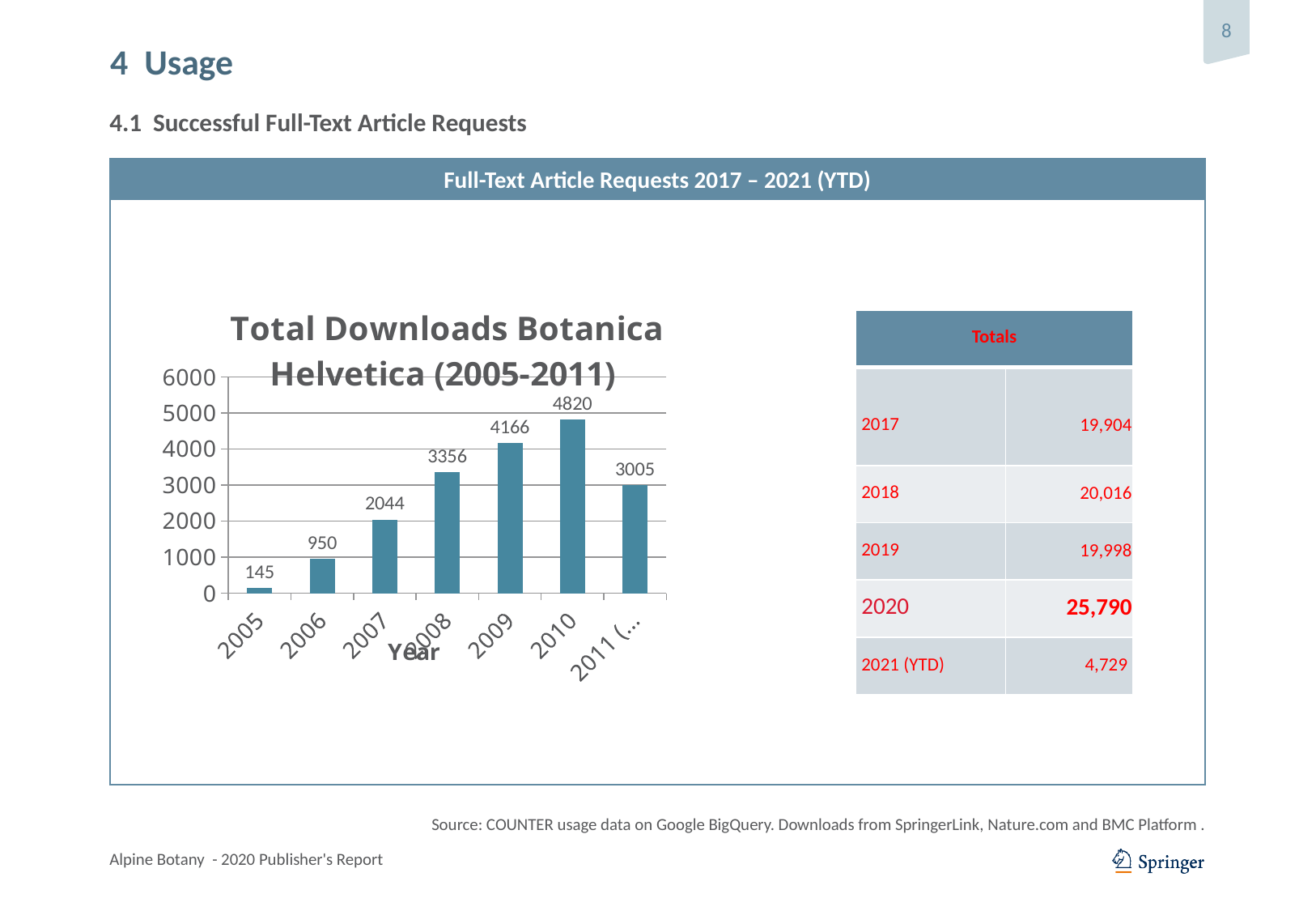
How many bars are plotted in the Total Downloads Botanica Helvetica chart? 7 What is the value for 2009 in the Total Downloads Botanica Helvetica chart? 4166 In the Total Downloads Botanica Helvetica chart, is the value for 2006 greater or less than 1000? less What is the difference between the values for 2010 and 2009 in the Total Downloads Botanica Helvetica chart? 654 What is the difference between the values for 2008 and 2007 in the Total Downloads Botanica Helvetica chart? 1312 In the Total Downloads Botanica Helvetica chart, do the values rise or fall from 2005 to 2010? rise What is the value for 2005 in the Total Downloads Botanica Helvetica chart? 145 What kind of chart is the Total Downloads Botanica Helvetica chart? bar chart Which year has the highest value in the Total Downloads Botanica Helvetica chart? 2010 In the Total Downloads Botanica Helvetica chart, which is larger, the value for 2008 or the value for 2006? 2008 Which year has the lowest value in the Total Downloads Botanica Helvetica chart? 2005 What is the value for 2007 in the Total Downloads Botanica Helvetica chart? 2044